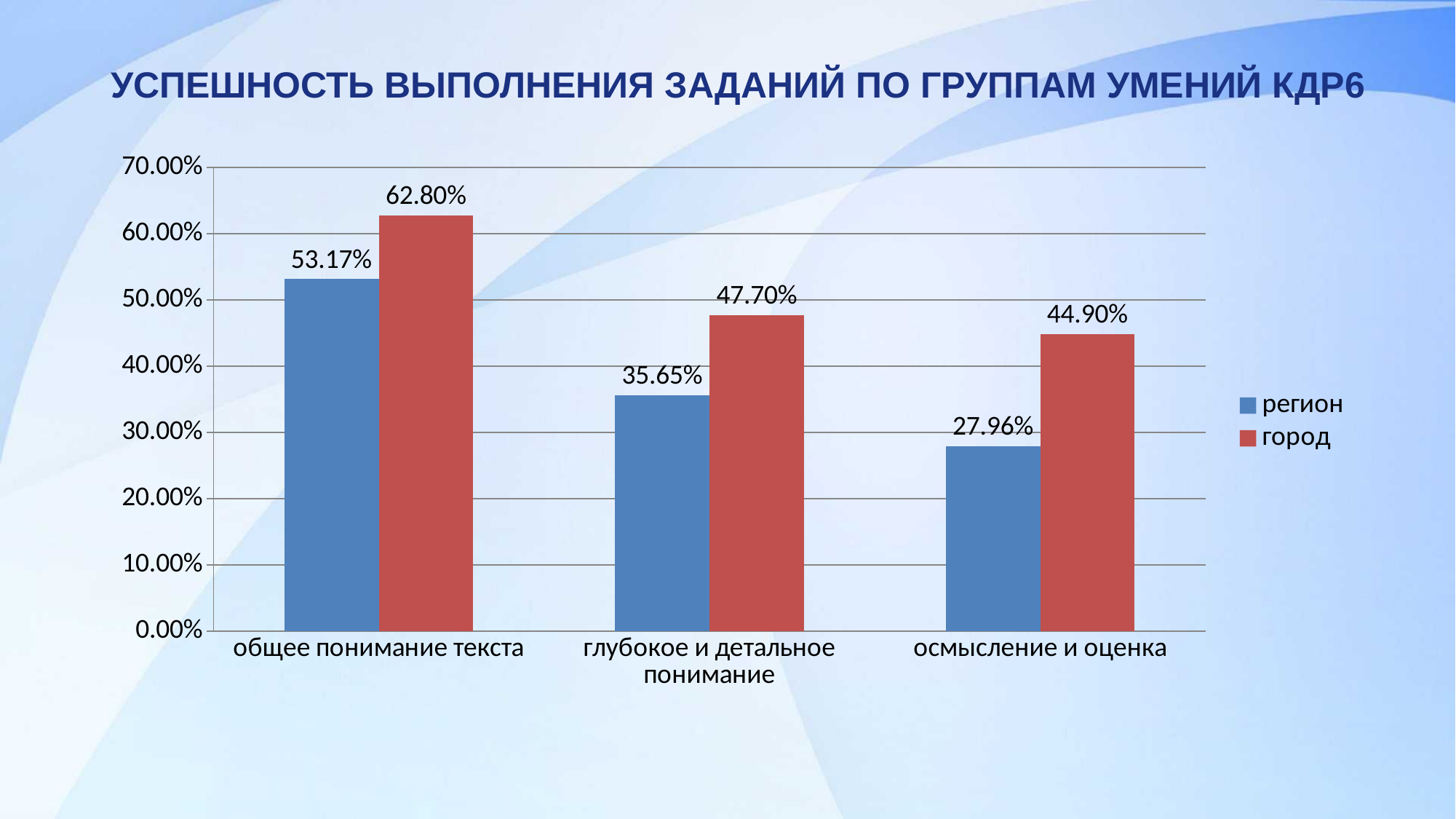
Which category has the lowest value for the город series? осмысление и оценка How many categories are shown on the x axis? 3 What kind of chart is shown on the slide? bar chart What is the value for город in the category осмысление и оценка? 44.90% What is the value for регион in the category общее понимание текста? 53.17% Which is larger in the category осмысление и оценка: регион or город? город Which category has the highest value for the регион series? общее понимание текста How many series does the legend list? 2 Which colour represents the город series? red What is the value for город in the category глубокое и детальное понимание? 47.70% What is the difference between город and регион in the category общее понимание текста? 9.63% Is the value for регион in глубокое и детальное понимание greater or less than 40.00%? less